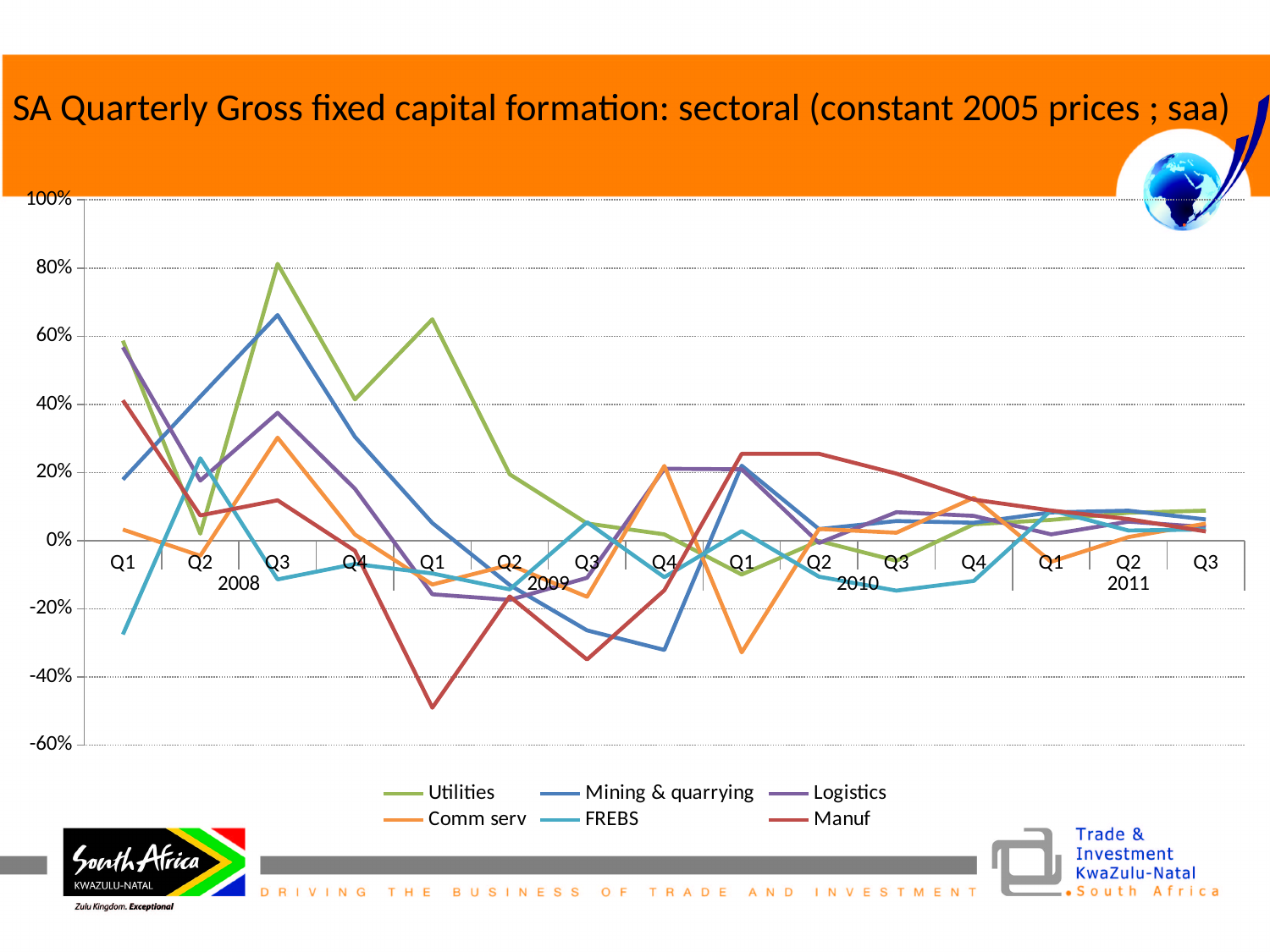
How many quarters are plotted along the x axis? 15 Which series reaches the highest value on the chart? Utilities Is the value for Utilities in Q3 2008 greater or less than 60%? greater Is the value for FREBS in Q1 2008 greater or less than -20%? less In Q3 2008, which is larger: the value for Utilities or the value for Comm serv? Utilities In Q1 2010, which is larger: the value for Manuf or the value for Comm serv? Manuf How many series does the legend list? 6 What kind of chart is shown on the slide? Line chart Is the value for Mining & quarrying in Q3 2008 greater or less than 60%? greater What is the title of the chart? SA Quarterly Gross fixed capital formation: sectoral (constant 2005 prices ; saa) Which series reaches the lowest value on the chart? Manuf